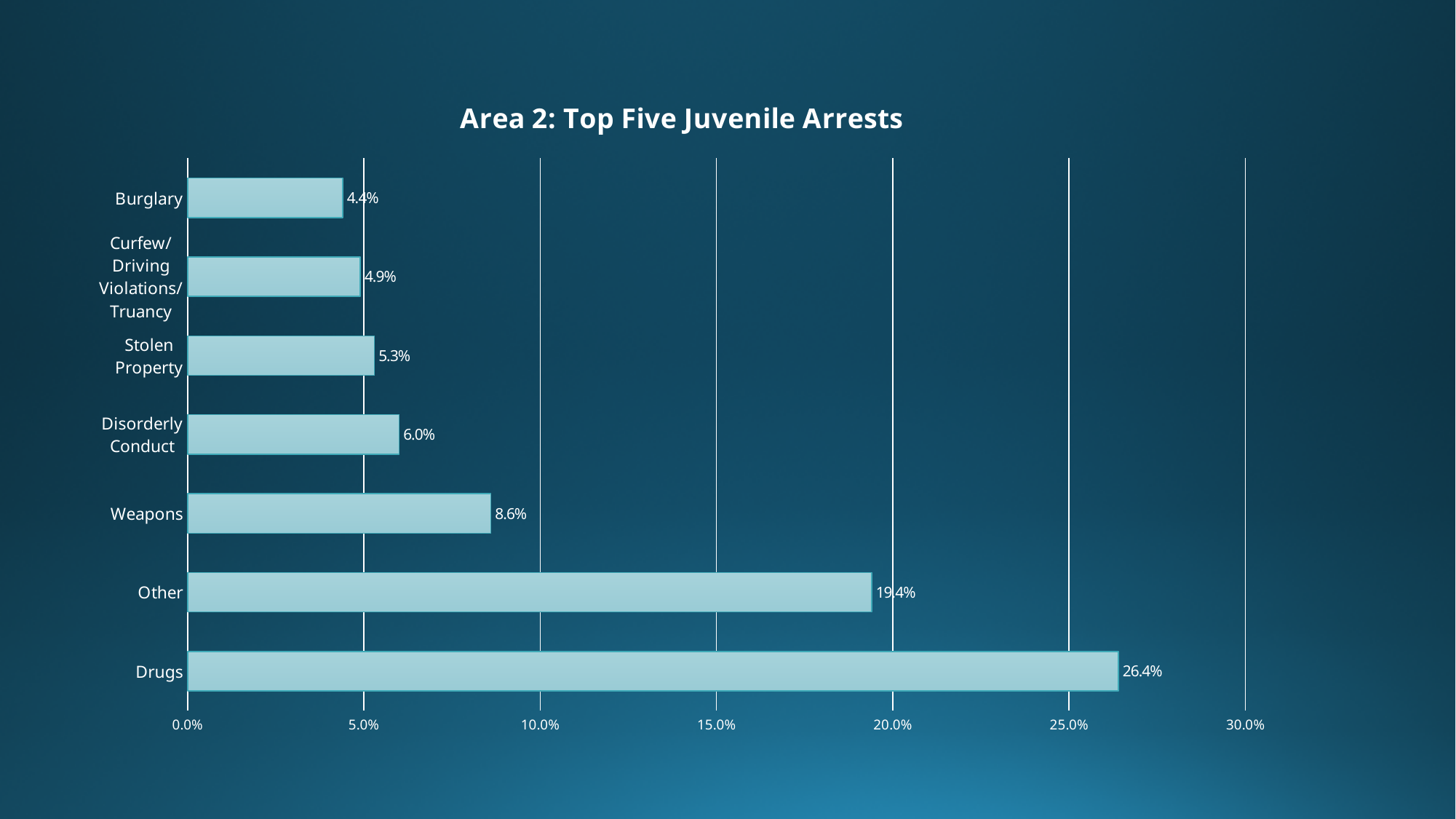
Which is larger, the value for Weapons or the value for Disorderly Conduct? Weapons What is the difference between the values for Disorderly Conduct and Burglary? 1.6% What is the value for Weapons? 8.6% What is the title of the chart? Area 2: Top Five Juvenile Arrests How many categories are shown in the chart? 7 Which category has the lowest value? Burglary Which category has the highest value? Drugs What kind of chart is shown on the slide? Bar chart What is the value for Drugs? 26.4% What is the value for Curfew/Driving Violations/Truancy? 4.9% What is the difference between the values for Drugs and Other? 7.0% What is the value for Stolen Property? 5.3%